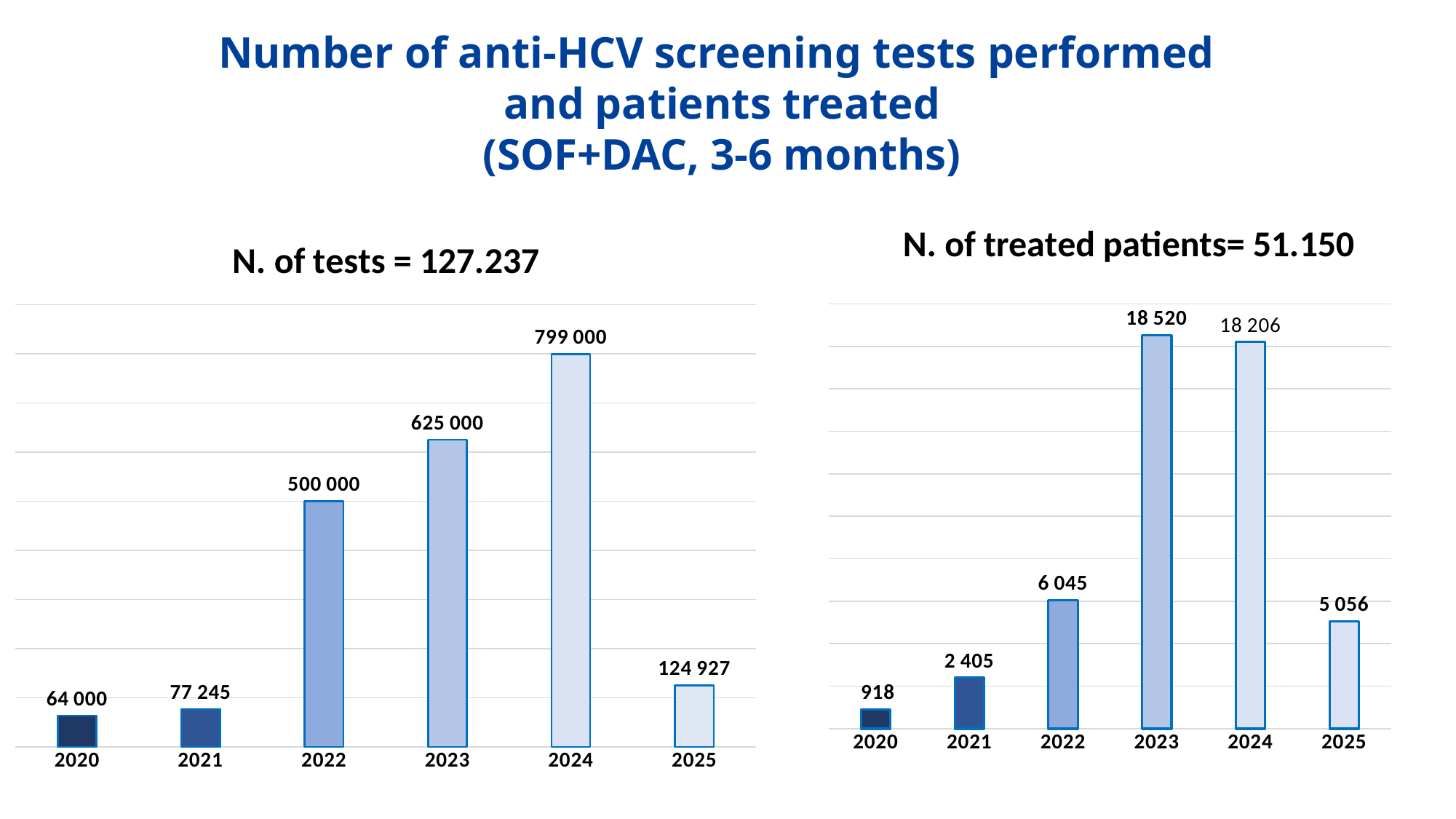
In the 'N. of treated patients' chart, what is the difference between the values for 2023 and 2024? 314 In the 'N. of treated patients' chart, which year has the lowest value? 2020 In the 'N. of tests' chart, what is the value for 2024? 799 000 In the 'N. of tests' chart, what is the value for 2021? 77 245 How many years are shown in the 'N. of treated patients' chart? 6 In the 'N. of tests' chart, what is the difference between the values for 2024 and 2023? 174 000 In the 'N. of treated patients' chart, which year has the highest value? 2023 In the 'N. of tests' chart, which is larger, the value for 2025 or the value for 2021? 2025 What kind of chart is the 'N. of tests' chart? Bar chart In the 'N. of treated patients' chart, what is the value for 2025? 5 056 In the 'N. of tests' chart, which year has the highest value? 2024 In the 'N. of treated patients' chart, what is the value for 2022? 6 045